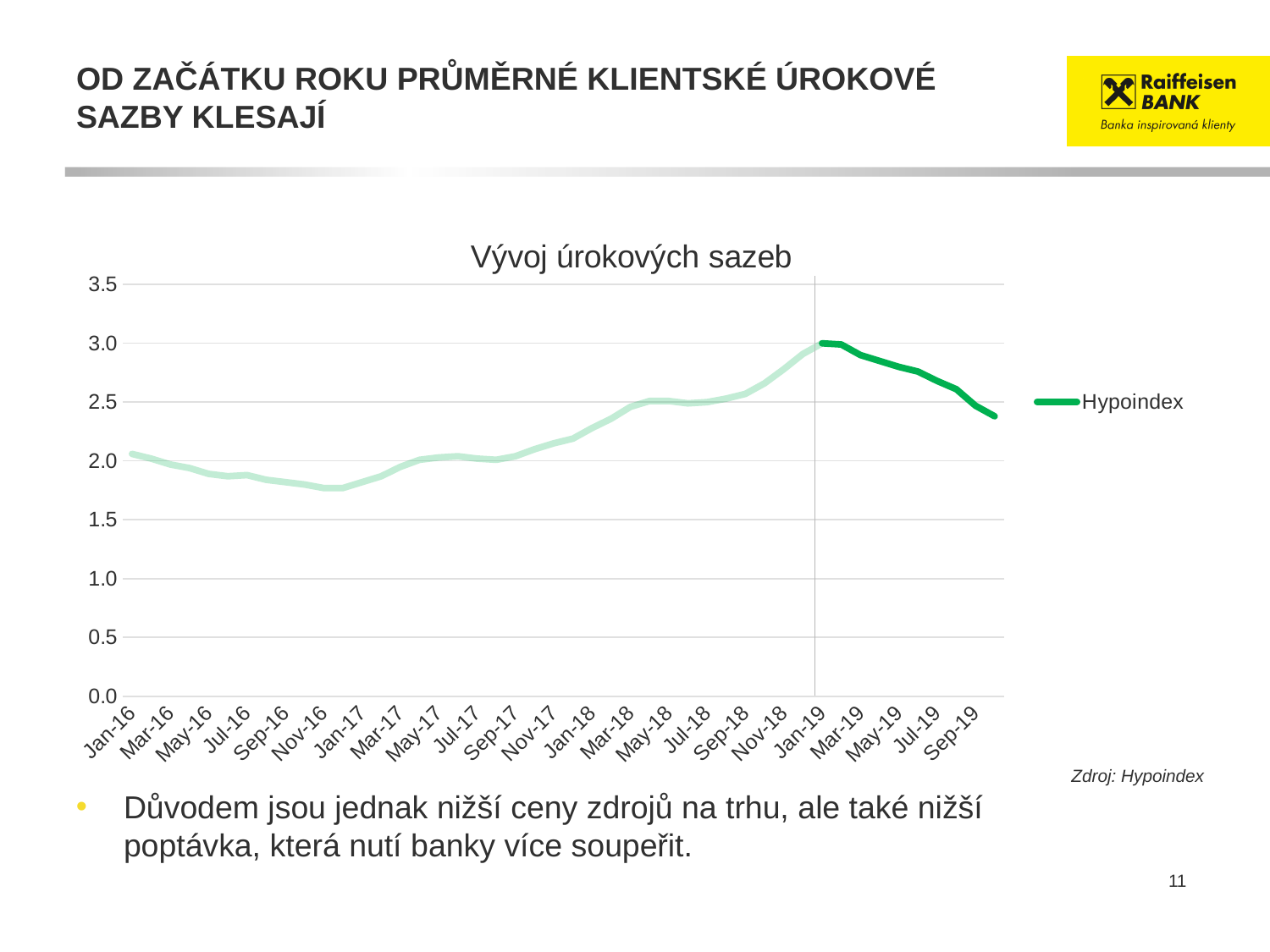
Does the Hypoindex line rise or fall between Jan-19 and Sep-19? fall How many series does the chart legend list? 1 What kind of chart is shown on the slide? line chart Is the value for May-19 greater or less than 2.5? greater Does the Hypoindex line rise or fall between Jan-17 and Jan-19? rise What is the title of the chart? Vývoj úrokových sazeb Which is larger, the value for Jan-19 or the value for Sep-19? Jan-19 In which month does the Hypoindex line reach its highest value? Jan-19 What is the name of the series shown in the legend? Hypoindex Is the value for Nov-16 greater or less than 2.0? less Is the value for Nov-18 greater or less than 2.5? greater